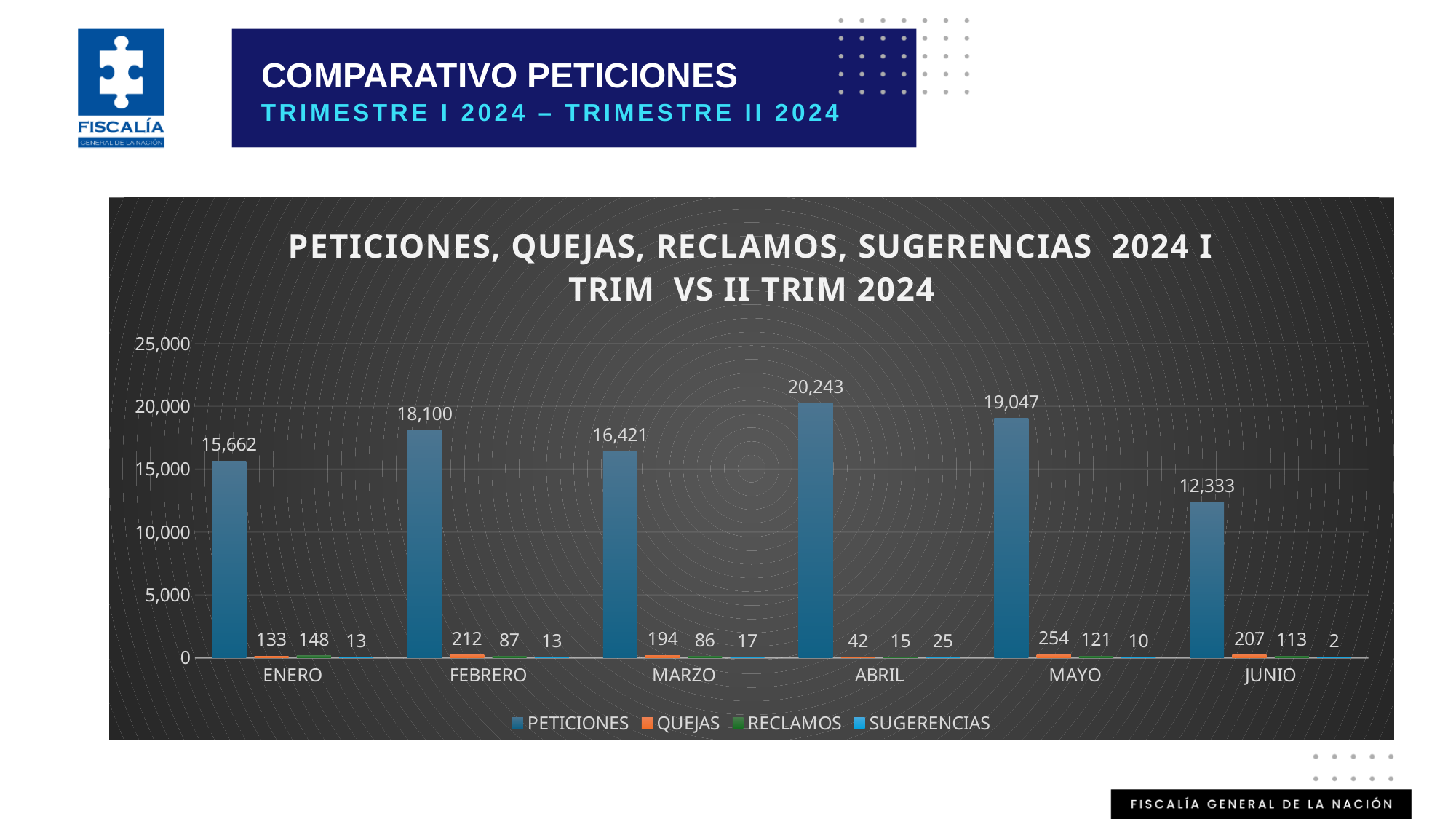
What is the RECLAMOS value for ENERO? 148 What kind of chart is shown on the slide? bar chart How many months are shown on the x axis? 6 What is the difference between the PETICIONES values for ABRIL and JUNIO? 7,910 What is the PETICIONES value for ABRIL? 20,243 Is the PETICIONES value for MAYO greater or less than 15,000? greater Which is larger, the PETICIONES value for FEBRERO or for MARZO? FEBRERO How many series does the legend list? 4 What is the SUGERENCIAS value for JUNIO? 2 What is the QUEJAS value for MAYO? 254 Which month has the lowest PETICIONES value? JUNIO Which month has the highest PETICIONES value? ABRIL